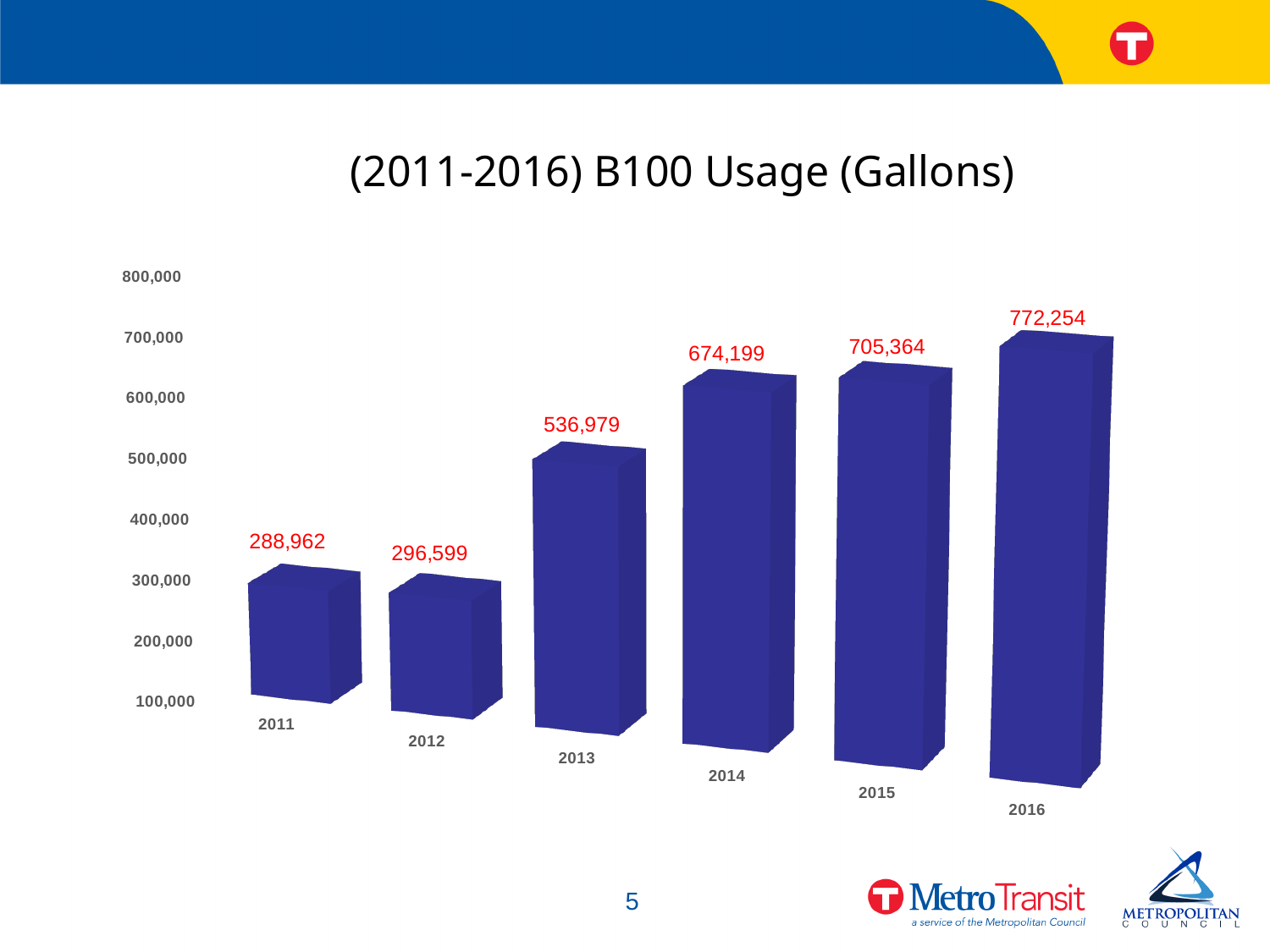
What was the B100 usage in gallons in 2016? 772,254 What was the B100 usage in gallons in 2011? 288,962 Which year had the lowest B100 usage? 2011 Which year had higher B100 usage, 2013 or 2014? 2014 What is the difference in B100 usage between 2012 and 2011? 7,637 Does B100 usage rise or fall from 2011 to 2016? Rise What was the B100 usage in gallons in 2014? 674,199 What is the difference in B100 usage between 2016 and 2015? 66,890 How many years are shown in the chart? 6 What is the title of the chart? (2011-2016) B100 Usage (Gallons) Which year had the highest B100 usage? 2016 What kind of chart is shown on the slide? Bar chart